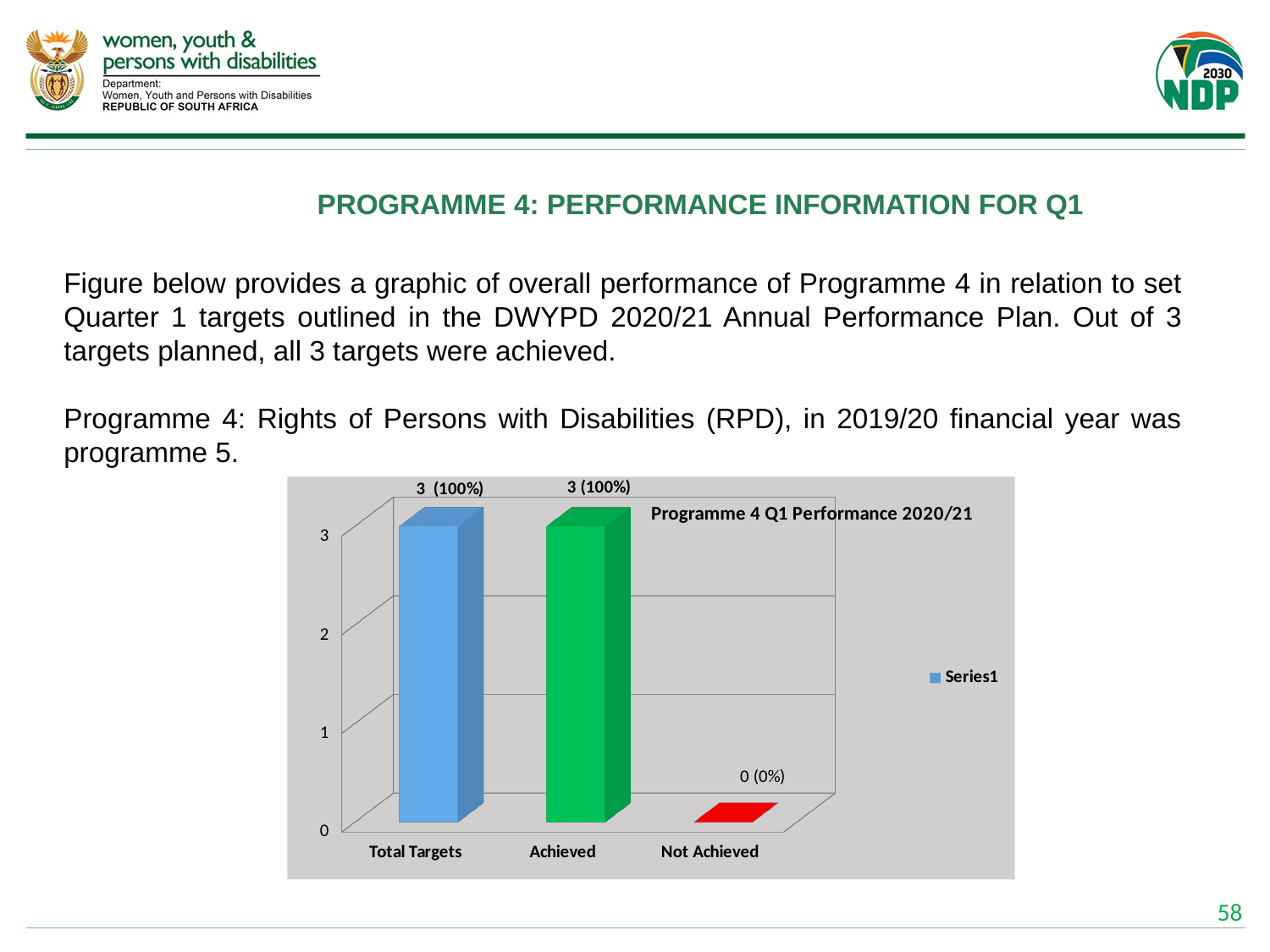
What is the value shown for Total Targets? 3 (100%) What is the title of the chart? Programme 4 Q1 Performance 2020/21 What is the difference between the Achieved value and the Not Achieved value? 3 Which category has the lowest value? Not Achieved What is the value shown for Not Achieved? 0 (0%) What kind of chart is shown on the slide? Bar chart Is the value for Total Targets greater or less than 2? greater How many series does the legend list? 1 What colour is the Achieved bar? Green Which is larger, the value for Achieved or the value for Not Achieved? Achieved How many categories are shown on the x axis? 3 What is the value shown for Achieved? 3 (100%)